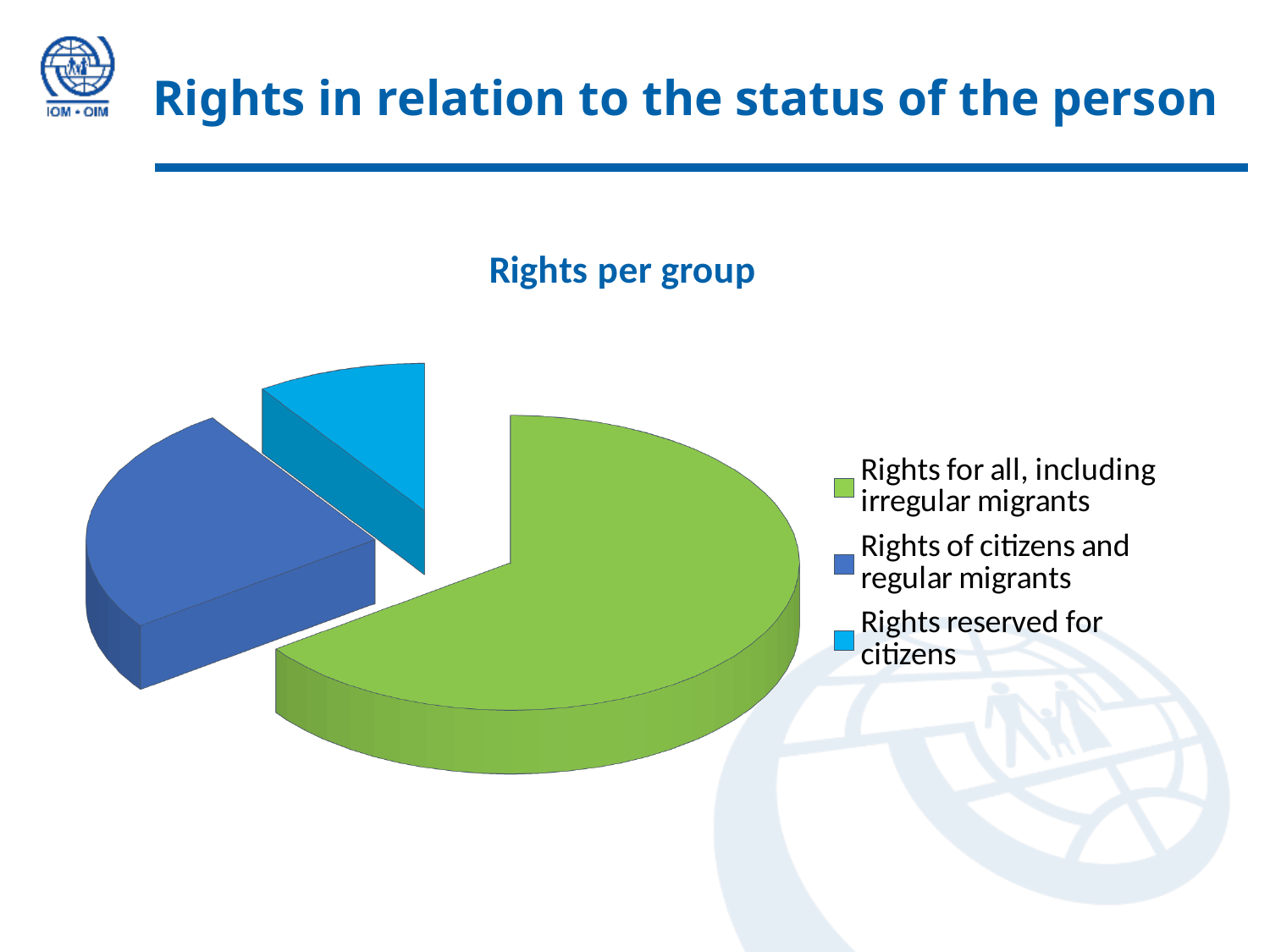
What kind of chart is shown on the slide? Pie chart Which slice is larger: 'Rights for all, including irregular migrants' or 'Rights of citizens and regular migrants'? Rights for all, including irregular migrants What is the title of the chart? Rights per group How many slices does the pie chart have? 3 Which category has the smallest slice of the pie? Rights reserved for citizens How many entries does the chart's legend list? 3 Which slice is larger: 'Rights of citizens and regular migrants' or 'Rights reserved for citizens'? Rights of citizens and regular migrants Does the slice for 'Rights for all, including irregular migrants' take up more or less than half of the pie? More Which category has the largest slice of the pie? Rights for all, including irregular migrants What colour is the slice for 'Rights for all, including irregular migrants'? Green